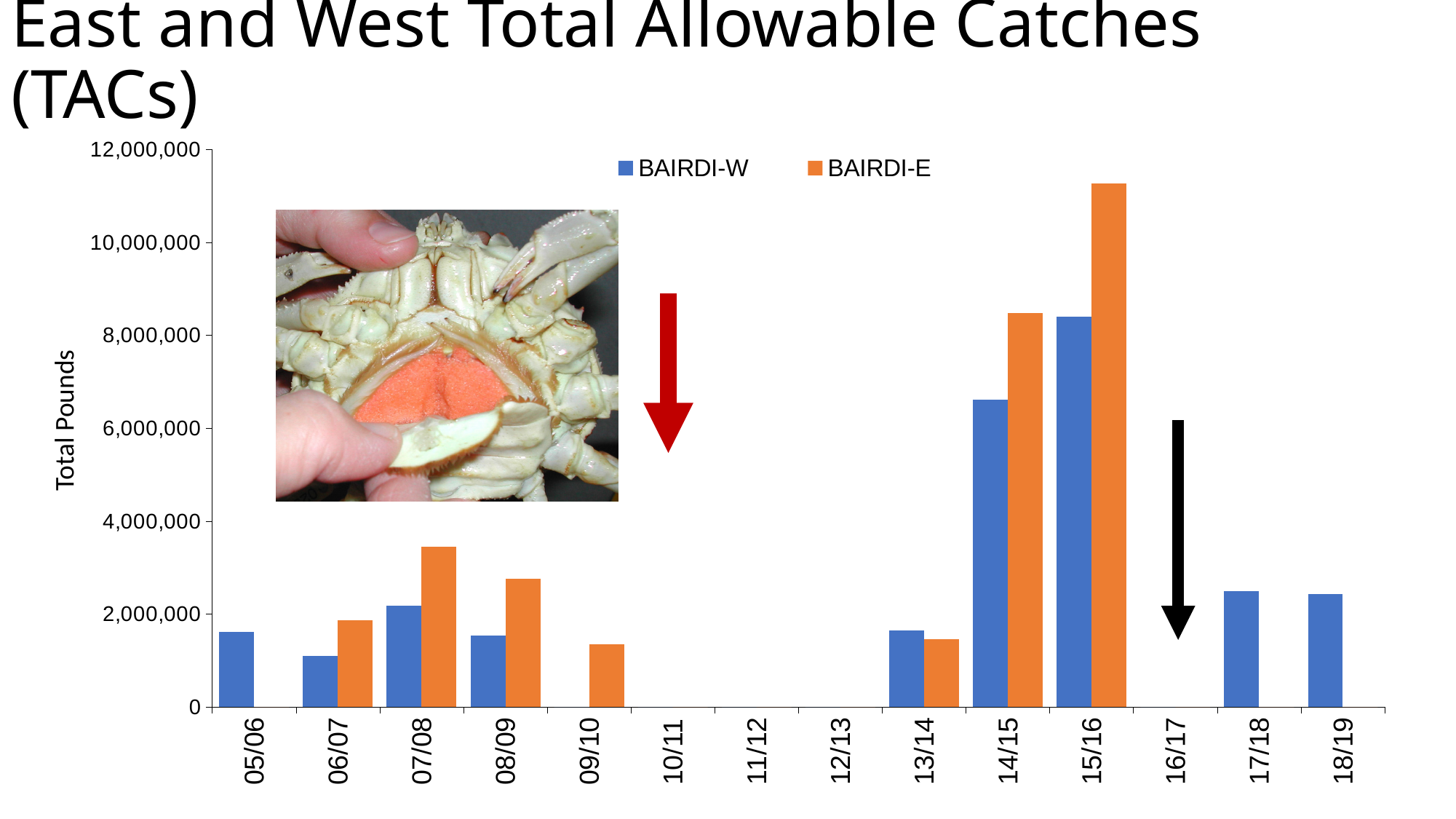
In which season is the BAIRDI-E value highest? 15/16 Is the BAIRDI-E value for 15/16 greater or less than 10,000,000? greater What is the label on the vertical axis? Total Pounds What kind of chart is shown on the slide? Bar chart Is the BAIRDI-E value for 07/08 greater or less than 4,000,000? less In which season is the BAIRDI-W value highest? 15/16 Is the BAIRDI-W value for 14/15 greater or less than 6,000,000? greater How many series does the legend list? 2 How many season categories are shown on the x axis? 14 In 14/15, which series has the larger value, BAIRDI-W or BAIRDI-E? BAIRDI-E How many seasons on the x axis have no bars for either series? 4